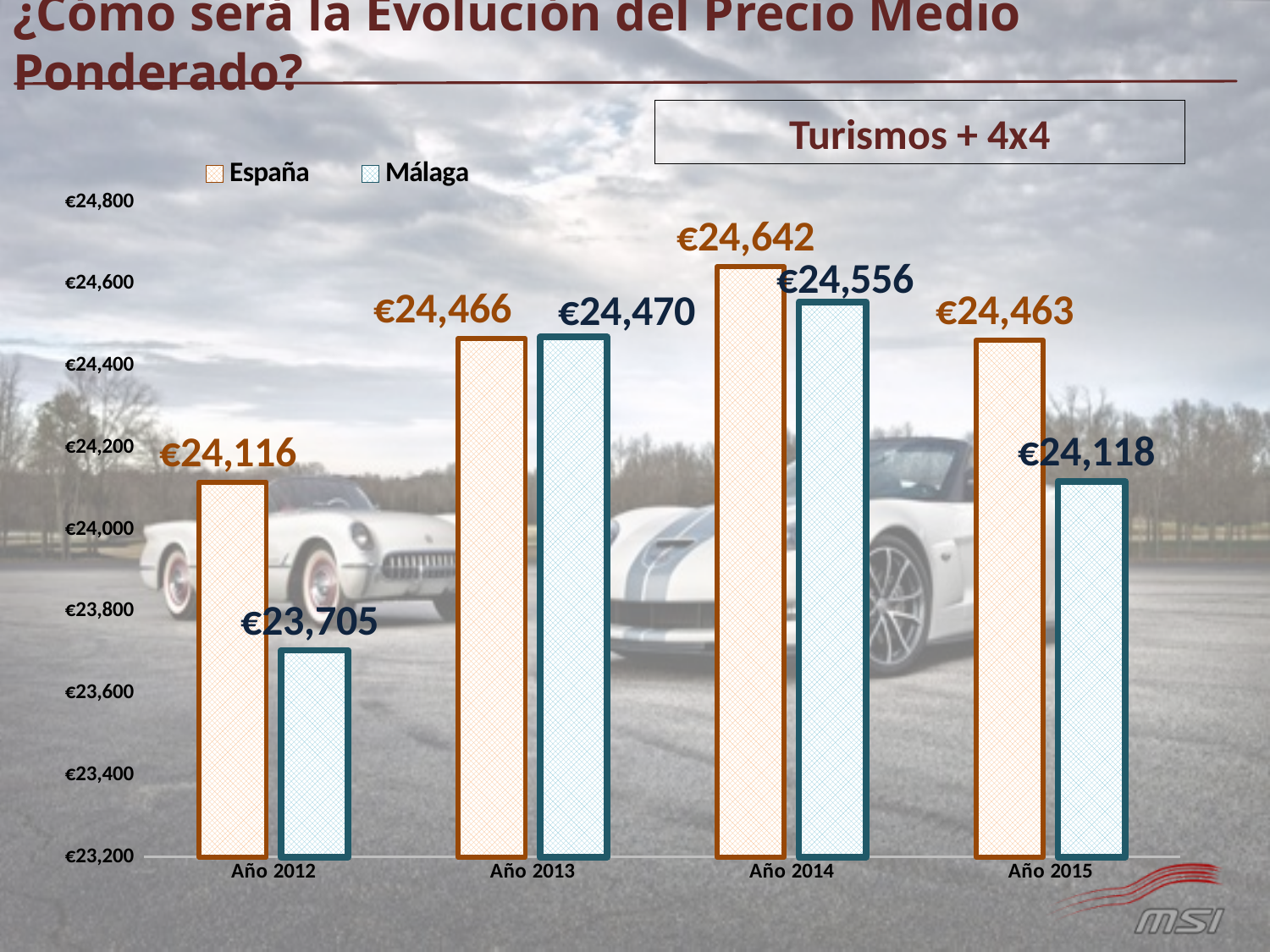
What is the value for Málaga in Año 2015? €24,118 What is the difference between the España values in Año 2014 and Año 2015? €179 Is the Málaga value for Año 2014 greater or less than €24,400? greater Which is larger in Año 2012, the España value or the Málaga value? España What kind of chart is shown on the slide? bar chart What is the value for Málaga in Año 2012? €23,705 In which year is the España value highest? Año 2014 In which year is the Málaga value lowest? Año 2012 What is the difference between the España and Málaga values in Año 2012? €411 How many series does the legend list? 2 How many years are shown on the x axis? 4 What is the value for España in Año 2014? €24,642